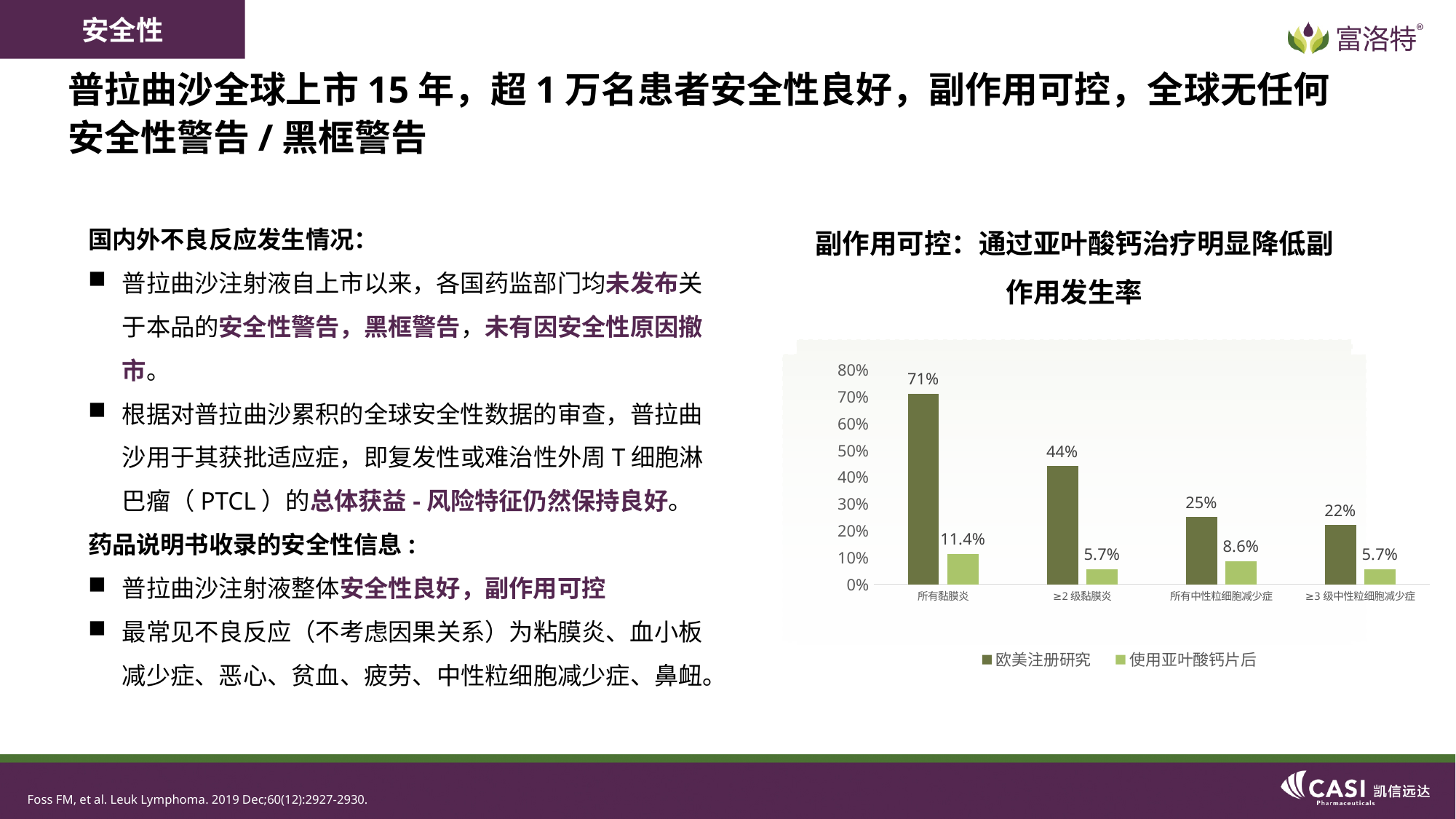
What is the difference between the 欧美注册研究 and 使用亚叶酸钙片后 values for ≥2级黏膜炎? 38.3% What is the value for ≥3级中性粒细胞减少症 in the 欧美注册研究 series? 22% What is the value for 所有黏膜炎 in the 使用亚叶酸钙片后 series? 11.4% What is the value for 所有黏膜炎 in the 欧美注册研究 series? 71% What is the value for 所有中性粒细胞减少症 in the 使用亚叶酸钙片后 series? 8.6% What kind of chart is shown on the slide? Bar chart Which category has the highest value in the 欧美注册研究 series? 所有黏膜炎 How many categories are shown on the x axis of the chart? 4 Which is larger: the 使用亚叶酸钙片后 value for 所有黏膜炎 or for 所有中性粒细胞减少症? 所有黏膜炎 Which category has the lowest value in the 欧美注册研究 series? ≥3级中性粒细胞减少症 Do the 欧美注册研究 values rise or fall from left to right across the categories? Fall How many series does the chart legend list? 2